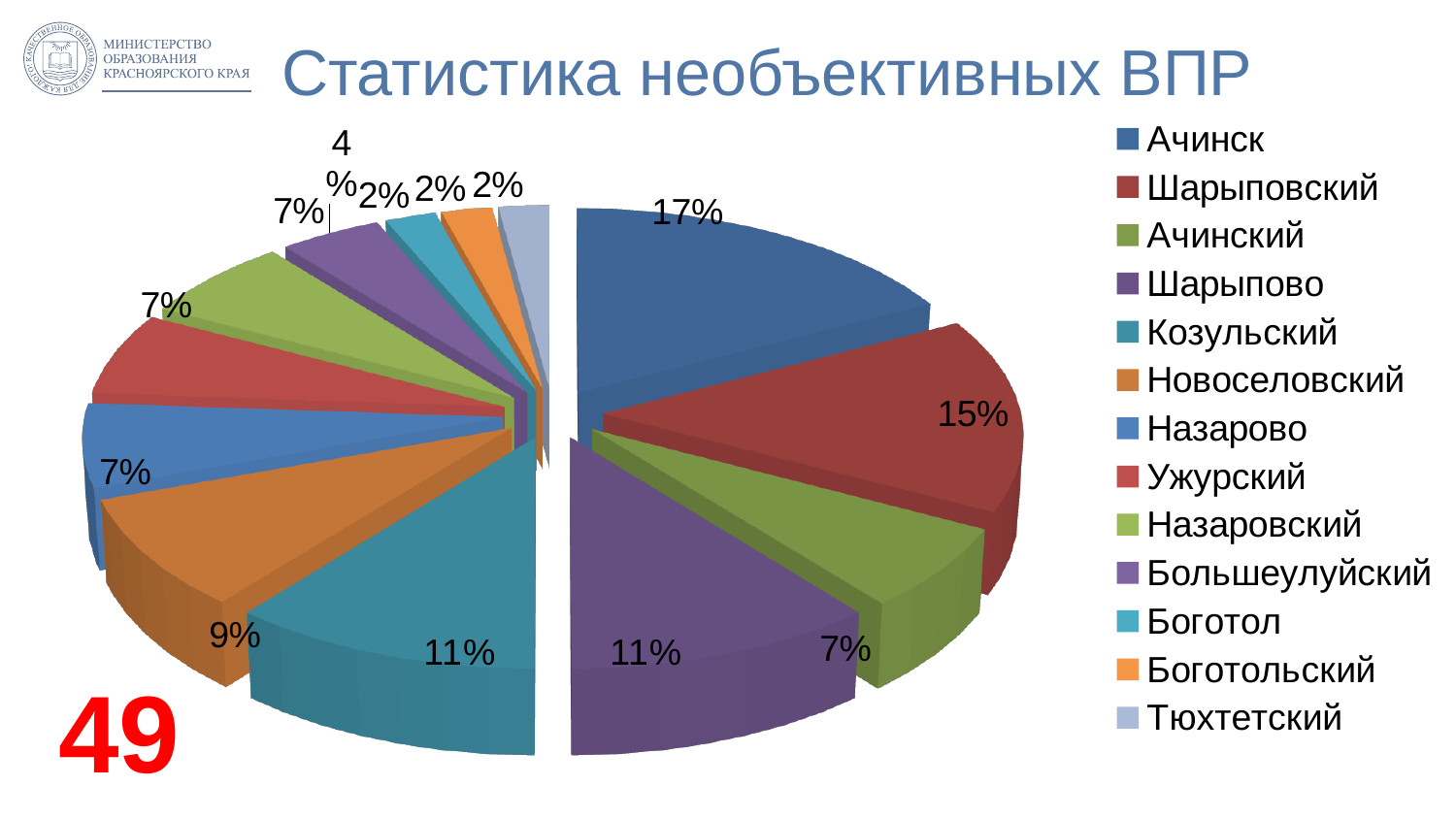
Which category has the largest slice of the pie? Ачинск What is the difference between the shares of Ачинск and Шарыповский? 2 percentage points What share of the pie does Ачинск account for? 17% What is the title of the slide containing the chart? Статистика необъективных ВПР What is the value shown for Новоселовский? 9% How many categories does the pie chart contain? 13 What kind of chart is shown on the slide? pie chart Which is larger, the share for Шарыпово or the share for Новоселовский? Шарыпово What is the value shown for Козульский? 11% What is the value shown for Большеулуйский? 4% Which category is listed last in the legend? Тюхтетский What is the value shown for Шарыповский? 15%